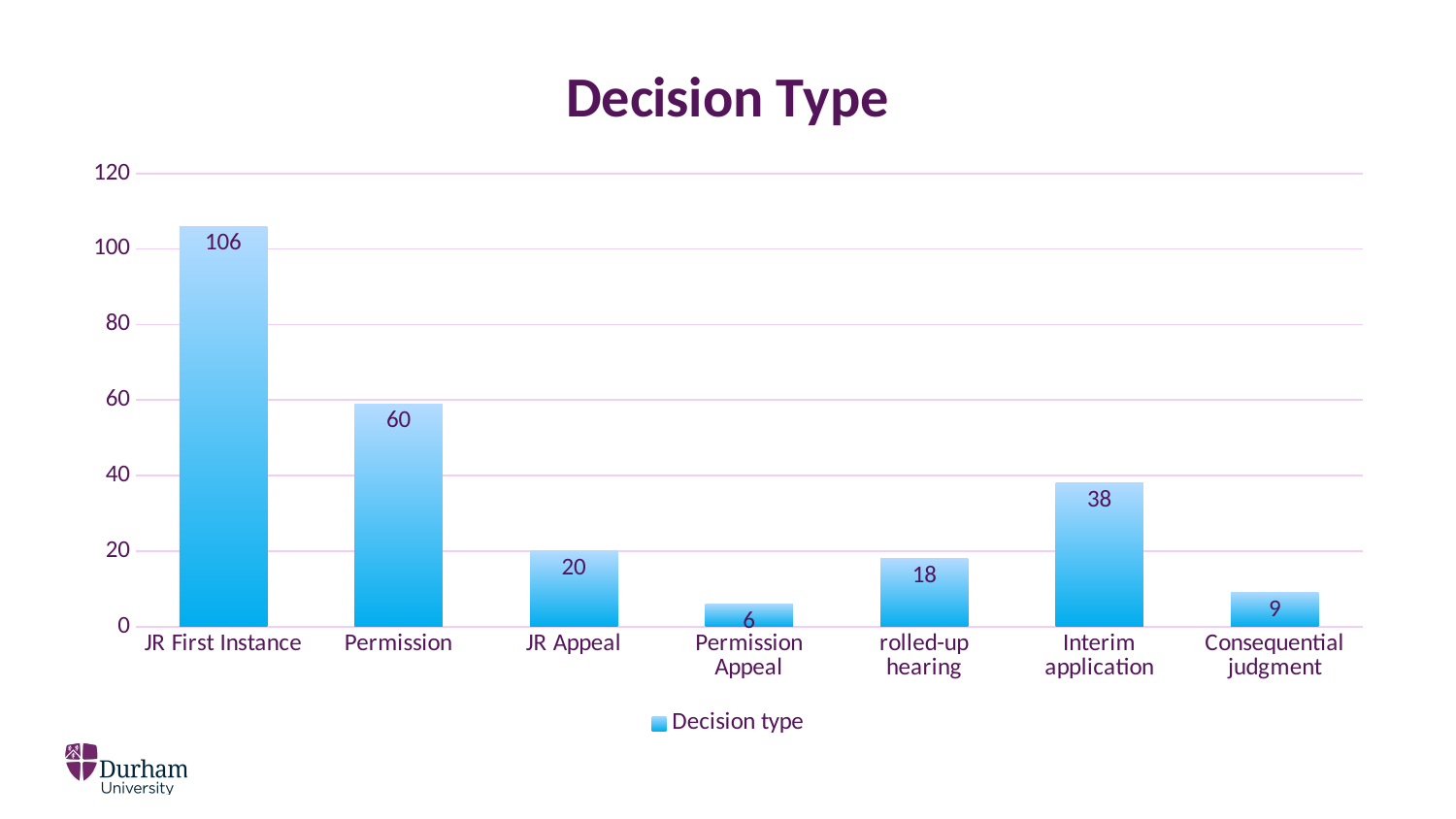
Which decision type has the lowest value? Permission Appeal What is the value for Interim application? 38 Is the value for Permission greater or less than 40? greater What is the value for JR First Instance? 106 What is the title of the chart? Decision Type How many decision types are shown on the chart? 7 What is the difference between the values for JR First Instance and Permission? 46 What is the value for rolled-up hearing? 18 What kind of chart is shown on the slide? Bar chart Which decision type has the highest value? JR First Instance What is the difference between the values for Interim application and Consequential judgment? 29 Which is larger, the value for JR Appeal or the value for rolled-up hearing? JR Appeal